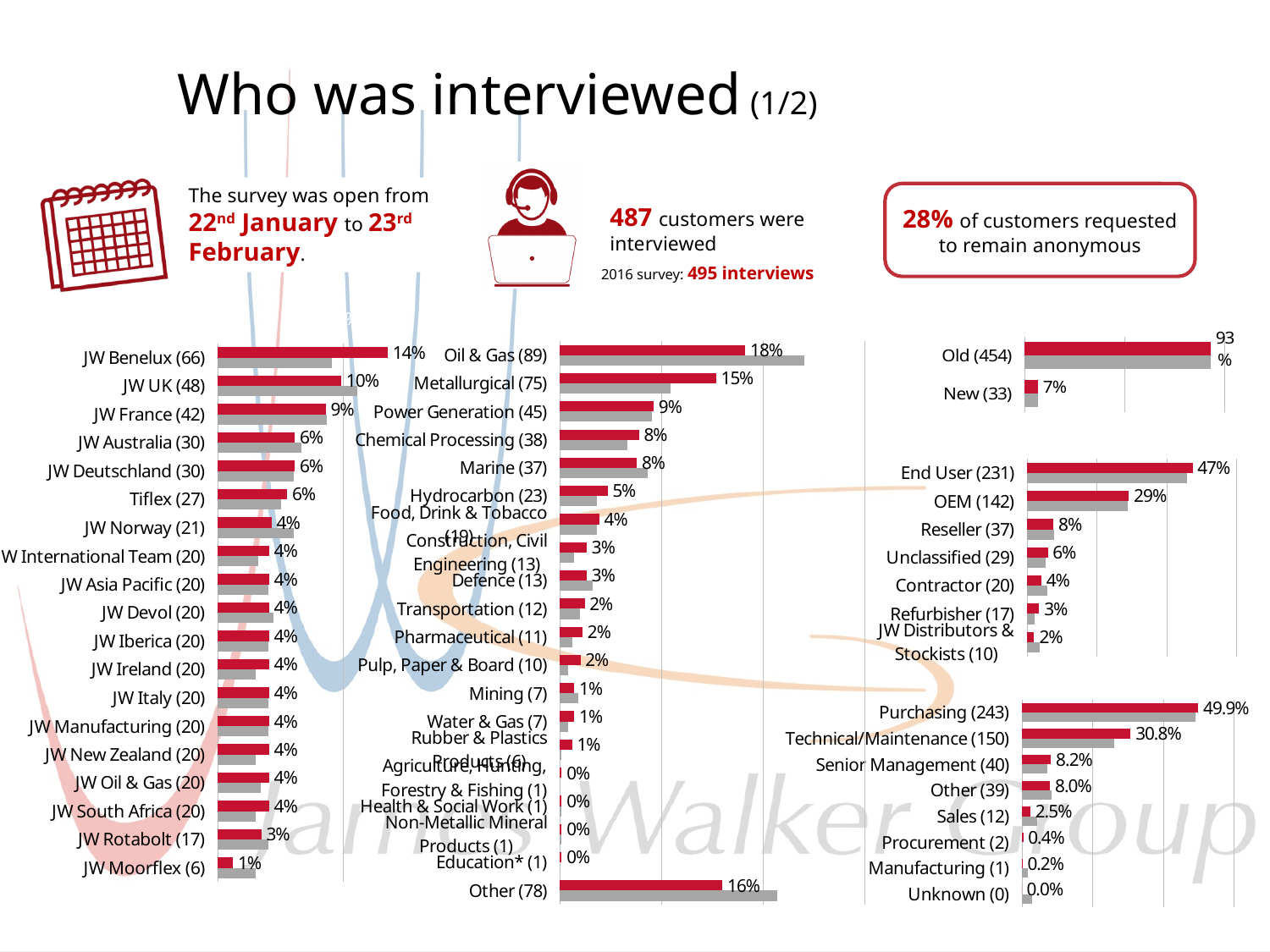
In the left-hand chart, which category has the highest red-bar value? JW Benelux (66) In the top-right chart, how many categories are shown? 2 What type of chart is the bottom-right chart? Bar chart In the middle chart, which has the larger red-bar value, Hydrocarbon (23) or Marine (37)? Marine (37) In the bottom-right chart, what is the red-bar value for Purchasing (243)? 49.9% In the left-hand chart, which category has the lowest red-bar value? JW Moorflex (6) In the top-right chart, what is the red-bar value for New (33)? 7% In the middle-right chart, what is the red-bar value for OEM (142)? 29% In the left-hand chart, what is the red-bar value for JW Benelux (66)? 14% In the middle chart, what is the difference between the red-bar values for Oil & Gas (89) and Power Generation (45)? 9% In the middle-right chart, what is the difference between the red-bar values for End User (231) and OEM (142)? 18% In the middle chart, what is the red-bar value for Metallurgical (75)? 15%